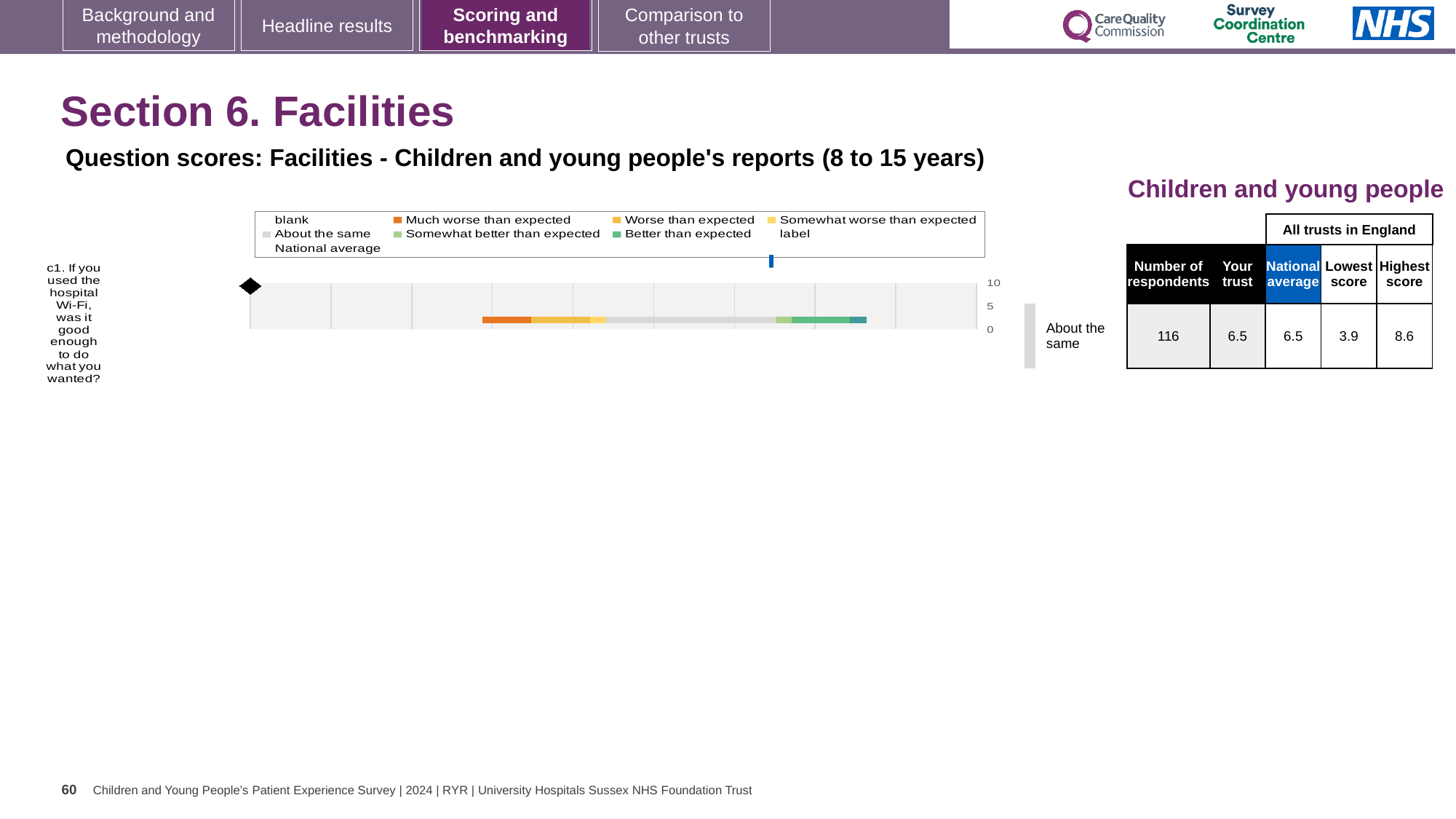
According to the table beside the chart, what is the 'Your trust' score for question c1? 6.5 Which survey question is plotted on the chart? c1. If you used the hospital Wi-Fi, was it good enough to do what you wanted? According to the table beside the chart, what is the lowest score among all trusts in England for question c1? 3.9 Is the 'Your trust' score for question c1 larger than, smaller than, or equal to the national average? equal According to the table beside the chart, how many respondents answered question c1? 116 According to the table beside the chart, what is the highest score among all trusts in England for question c1? 8.6 What kind of chart is shown on the slide? bar chart What is the difference between the highest score and the lowest score for question c1 in the table beside the chart? 4.7 According to the table beside the chart, what is the national average score for question c1? 6.5 What benchmark category is the trust's result for question c1 labelled as next to the chart? About the same What is the highest value shown on the chart's axis? 10 How many survey questions (categories) are plotted on the chart? 1